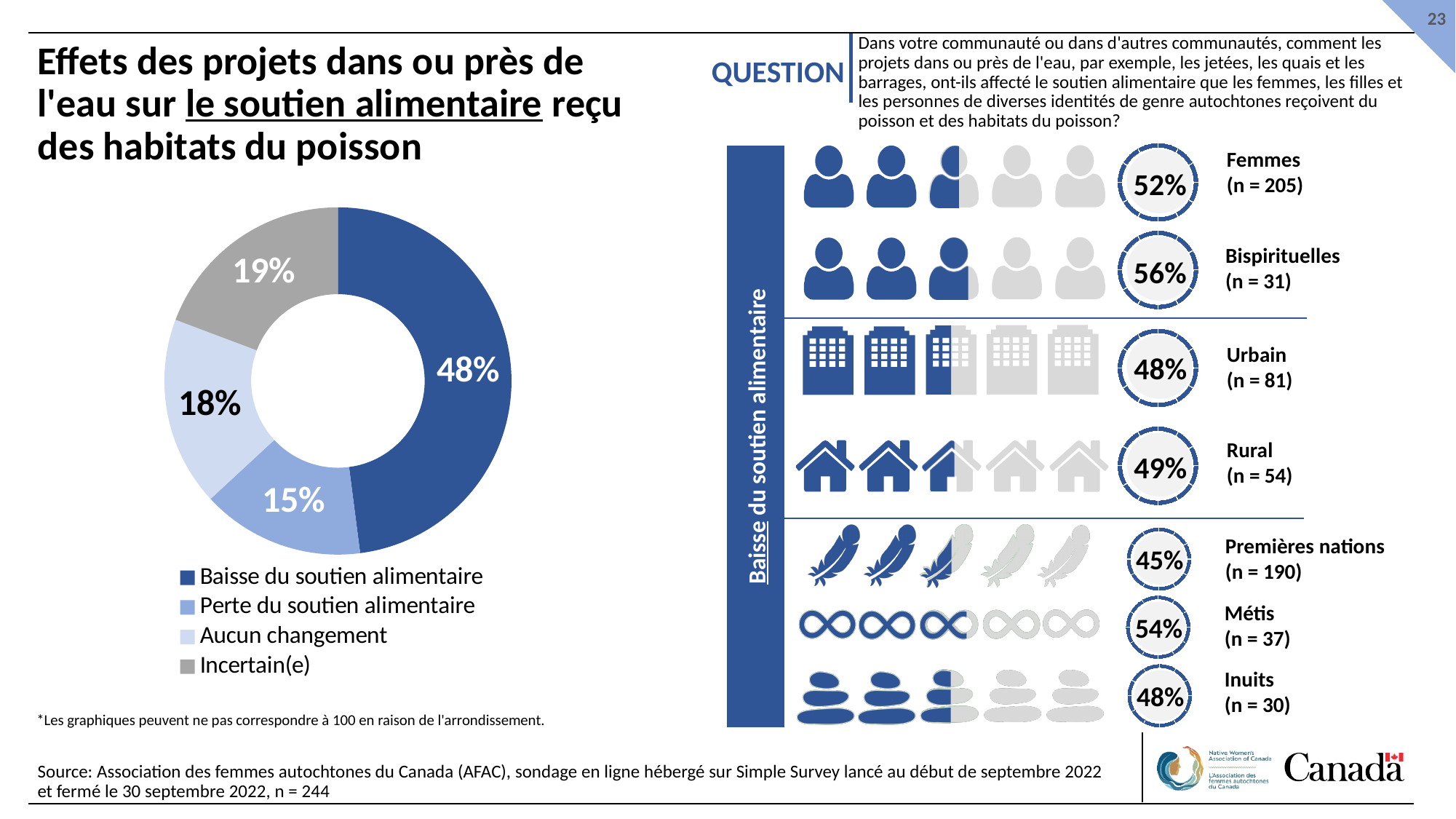
In the donut chart on the left, what share is labelled for 'Incertain(e)'? 19% In the donut chart on the left, what is the difference in percentage points between 'Baisse du soutien alimentaire' and 'Perte du soutien alimentaire'? 33 In the infographic on the right, which group has the lowest percentage for 'Baisse du soutien alimentaire'? Premières nations In the donut chart on the left, which category has the largest share? Baisse du soutien alimentaire In the donut chart on the left, what share is labelled for 'Baisse du soutien alimentaire'? 48% In the donut chart on the left, what share is labelled for 'Aucun changement'? 18% In the infographic on the right, what is the difference in percentage points between 'Rural' and 'Urbain'? 1 How many categories does the legend of the donut chart on the left list? 4 In the donut chart on the left, which is larger: 'Aucun changement' or 'Incertain(e)'? Incertain(e) In the donut chart on the left, which category has the smallest share? Perte du soutien alimentaire What kind of chart is shown on the left of the slide? Donut (pie) chart In the infographic on the right, what percentage is shown for 'Bispirituelles'? 56%